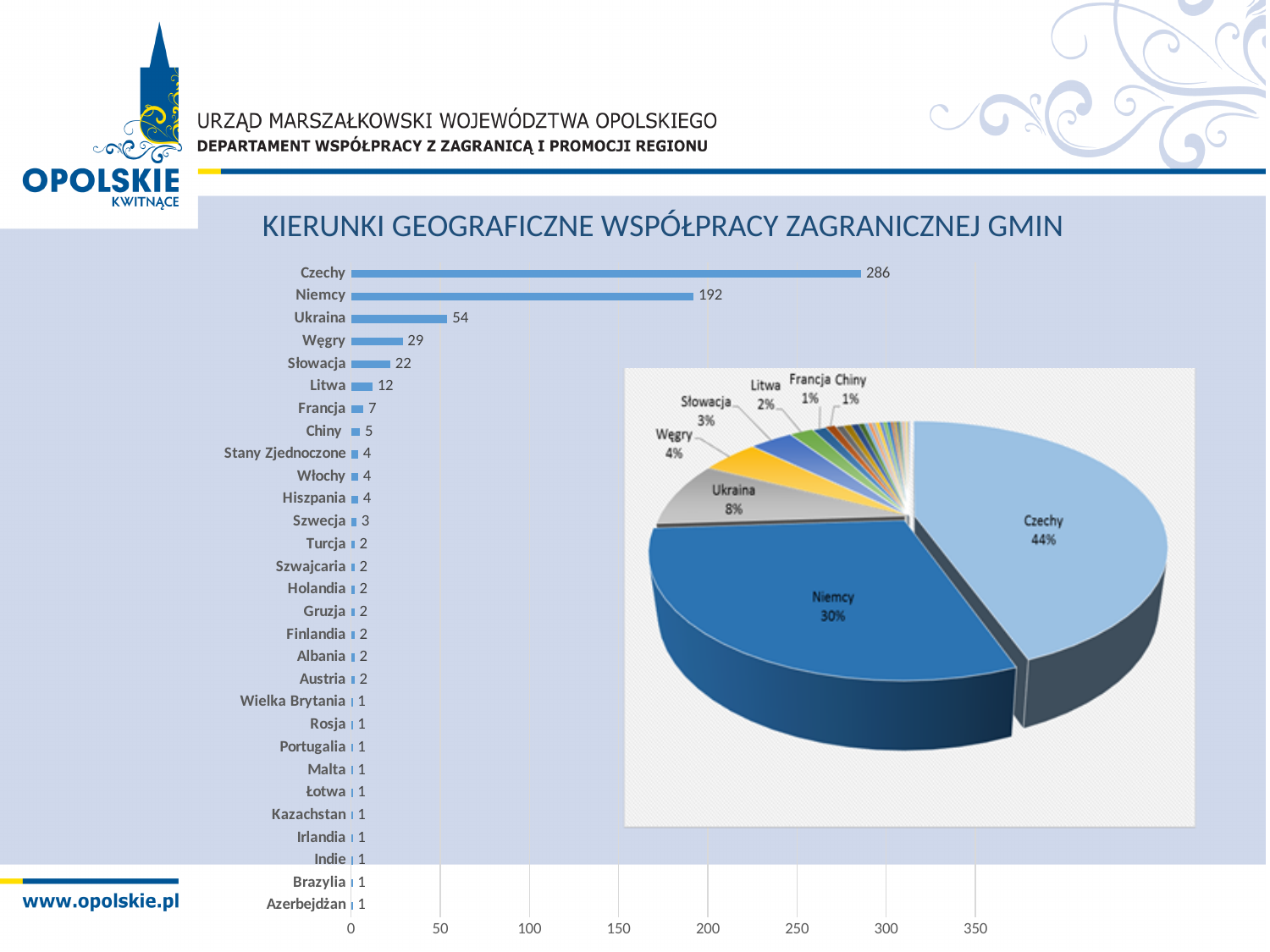
On the pie chart, what share does Ukraina have? 8% On the bar chart, which country has the highest value? Czechy On the bar chart, what is the value for Czechy? 286 On the bar chart, is the value for Niemcy greater or less than 150? greater On the bar chart, what is the value for Słowacja? 22 On the pie chart, what share does Niemcy have? 30% What is the title of the slide's chart section? KIERUNKI GEOGRAFICZNE WSPÓŁPRACY ZAGRANICZNEJ GMIN On the bar chart, what is the value for Ukraina? 54 On the bar chart, what is the difference between the values for Czechy and Niemcy? 94 On the bar chart, which is larger, the value for Węgry or the value for Litwa? Węgry On the bar chart, how many countries are listed? 29 What kind of chart is the chart on the left side of the slide? bar chart